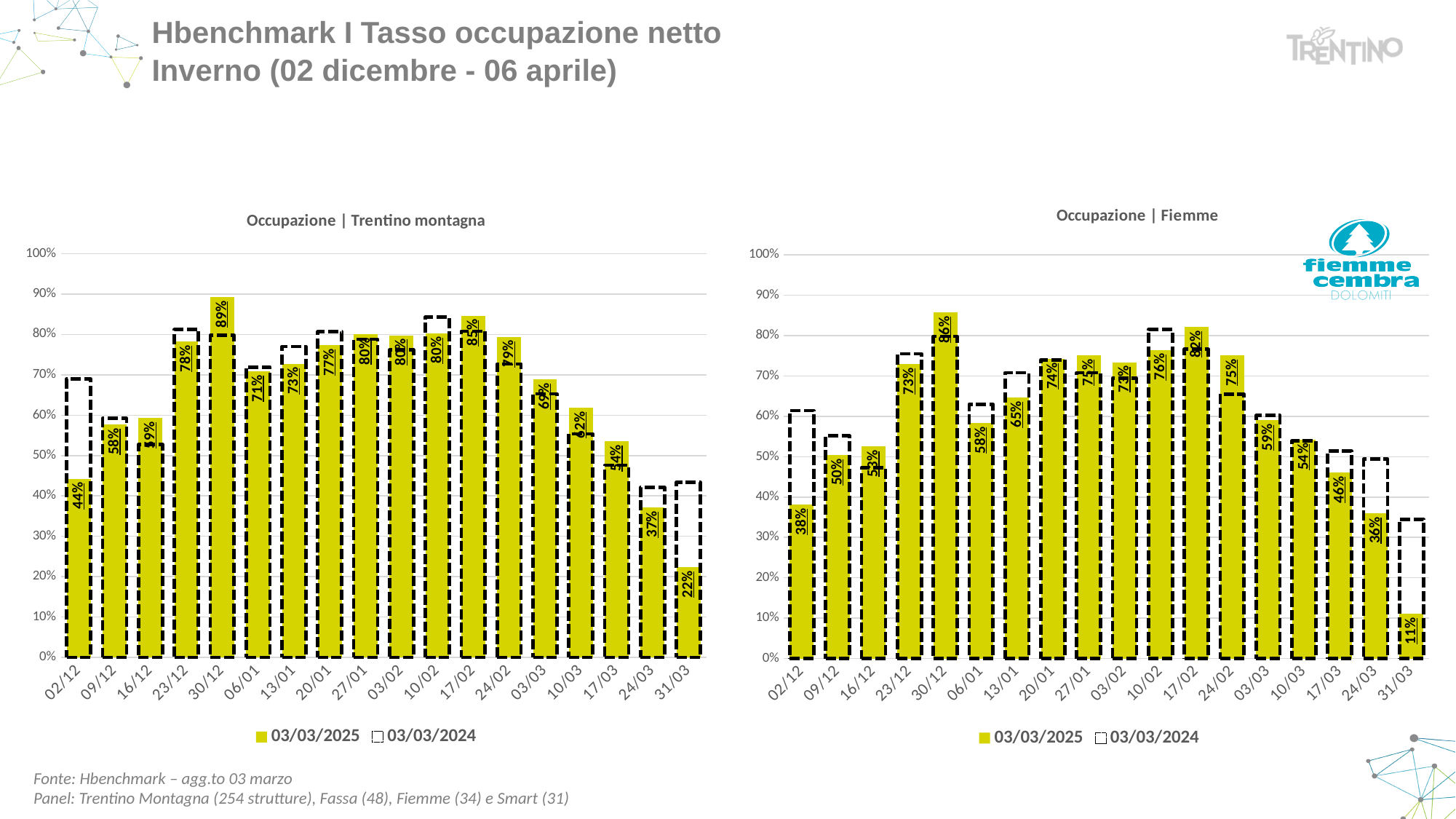
In the 'Occupazione | Trentino montagna' chart, what is the 03/03/2025 value for 30/12? 89% In the 'Occupazione | Trentino montagna' chart, which week has the lowest 03/03/2025 value? 31/03 In the 'Occupazione | Trentino montagna' chart, is the 03/03/2024 value for 02/12 greater or less than 60%? greater In the 'Occupazione | Fiemme' chart, what is the 03/03/2025 value for 31/03? 11% In the 'Occupazione | Trentino montagna' chart, which week has the highest 03/03/2025 value? 30/12 What kind of chart is the 'Occupazione | Fiemme' chart? bar chart In the 'Occupazione | Trentino montagna' chart, what is the difference between the 03/03/2025 values for 30/12 and 31/03? 67 percentage points In the 'Occupazione | Trentino montagna' chart, for 02/12, which series is larger: 03/03/2025 or 03/03/2024? 03/03/2024 In the 'Occupazione | Fiemme' chart, which week has the highest 03/03/2025 value? 30/12 How many series does the legend of the 'Occupazione | Trentino montagna' chart list? 2 How many weeks are shown on the x axis of the 'Occupazione | Fiemme' chart? 18 In the 'Occupazione | Fiemme' chart, what is the difference between the 03/03/2025 values for 30/12 and 02/12? 48 percentage points